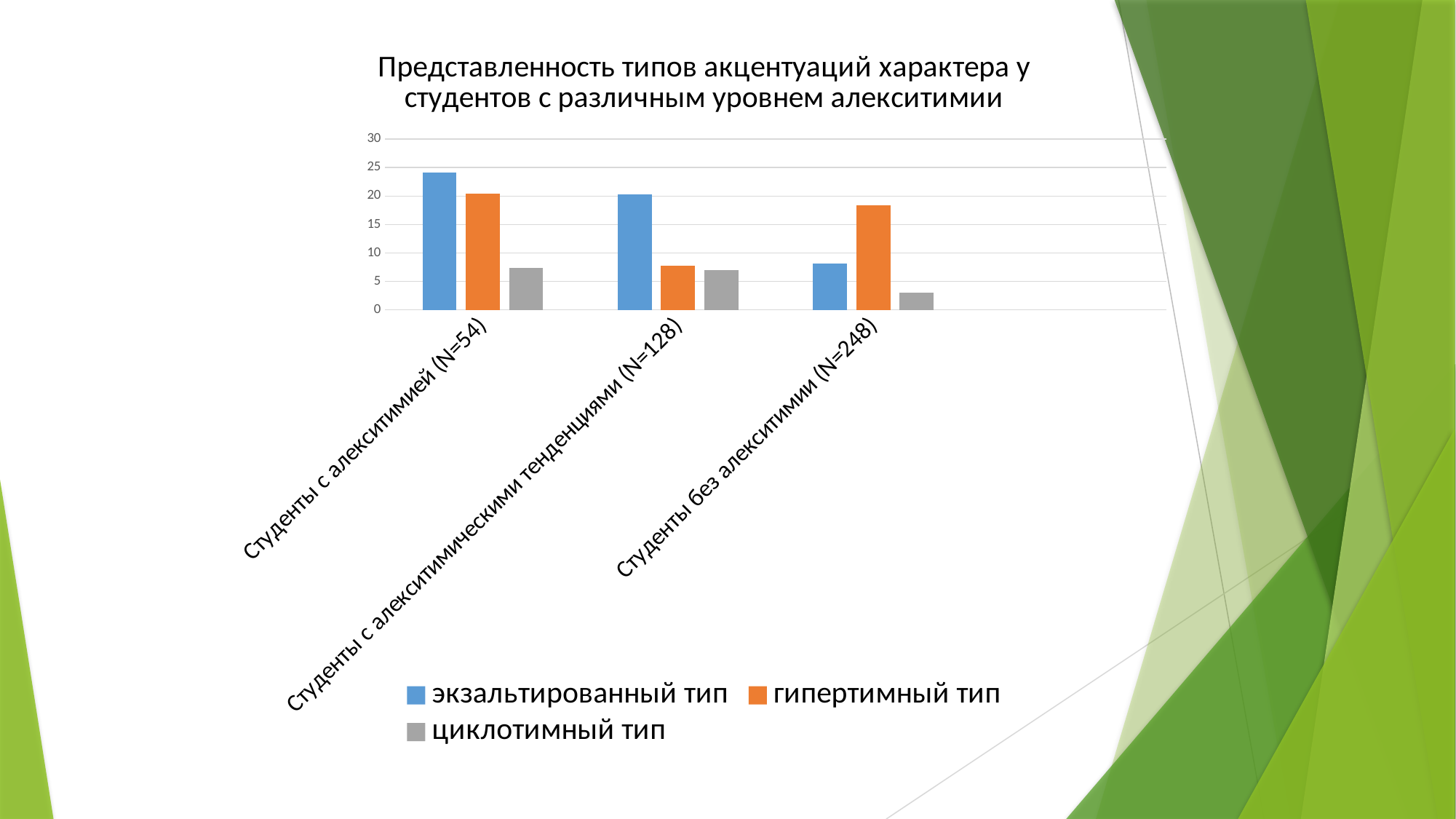
Which category has the highest value for экзальтированный тип? Студенты с алекситимией (N=54) What is the title of the chart? Представленность типов акцентуаций характера у студентов с различным уровнем алекситимии Is the value for экзальтированный тип among Студенты с алекситимией (N=54) greater or less than 20? greater Is the value for циклотимный тип among Студенты без алекситимии (N=248) greater or less than 5? less Which category has the lowest value for экзальтированный тип? Студенты без алекситимии (N=248) For Студенты без алекситимии (N=248), which is larger: экзальтированный тип or гипертимный тип? гипертимный тип How many categories are shown on the x axis of the chart? 3 How many series does the legend list? 3 Which category has the lowest value for гипертимный тип? Студенты с алекситимическими тенденциями (N=128) Which category has the lowest value for циклотимный тип? Студенты без алекситимии (N=248) What kind of chart is shown on the slide? bar chart Which series is shown in orange in the legend? гипертимный тип